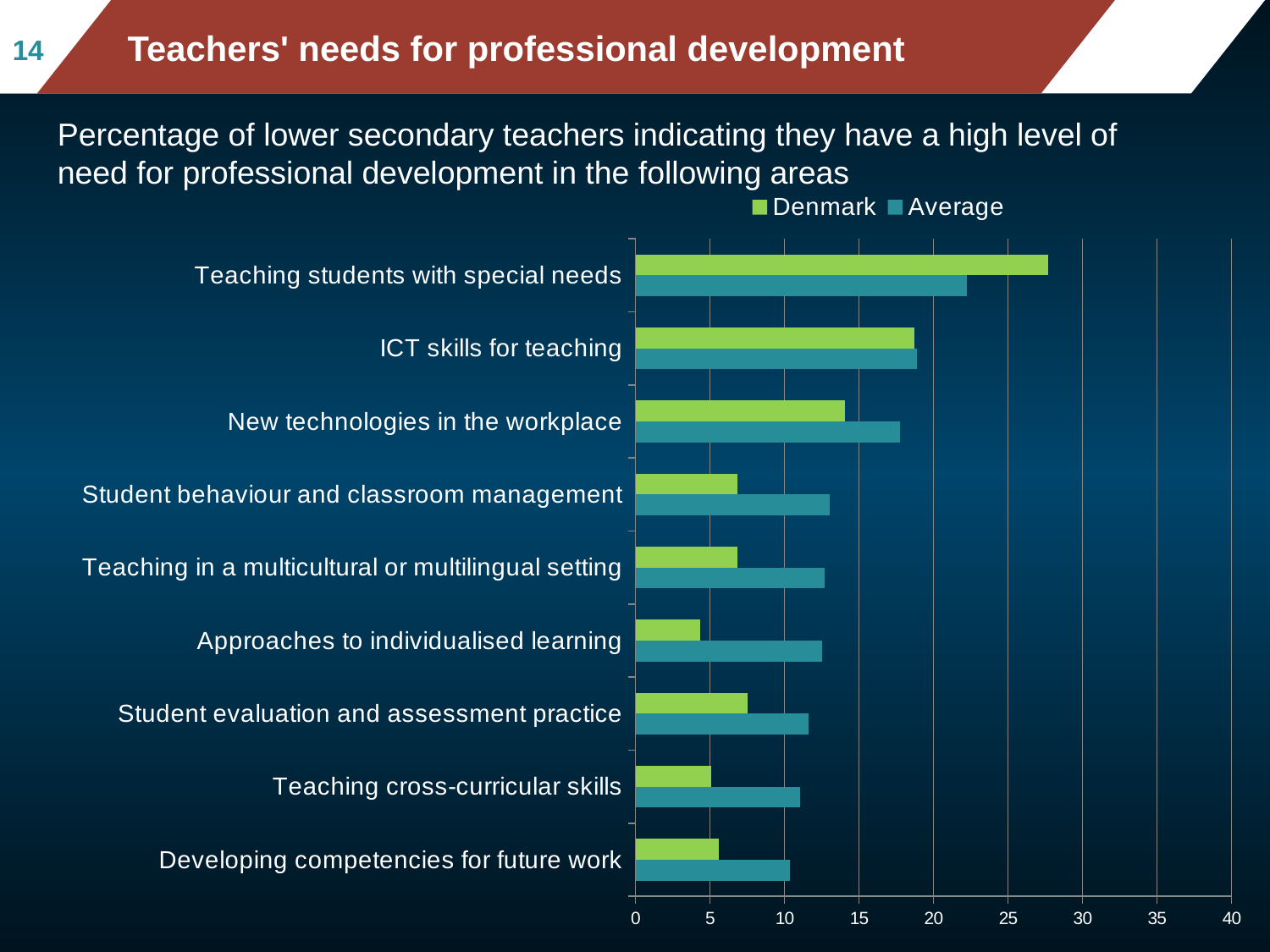
Which area has the highest value for Denmark? Teaching students with special needs For Approaches to individualised learning, which is larger: the Denmark value or the Average value? Average What kind of chart is shown on the slide? bar chart Is the Average value for New technologies in the workplace greater or less than 15? greater Is the Denmark value for Teaching students with special needs greater or less than 25? greater How many professional development areas (categories) are shown on the chart? 9 Which colour represents the Denmark series in the legend? green For Teaching students with special needs, which is larger: the Denmark value or the Average value? Denmark Which area has the highest value for Average? Teaching students with special needs Is the Average value for Teaching students with special needs greater or less than 20? greater How many series does the legend list? 2